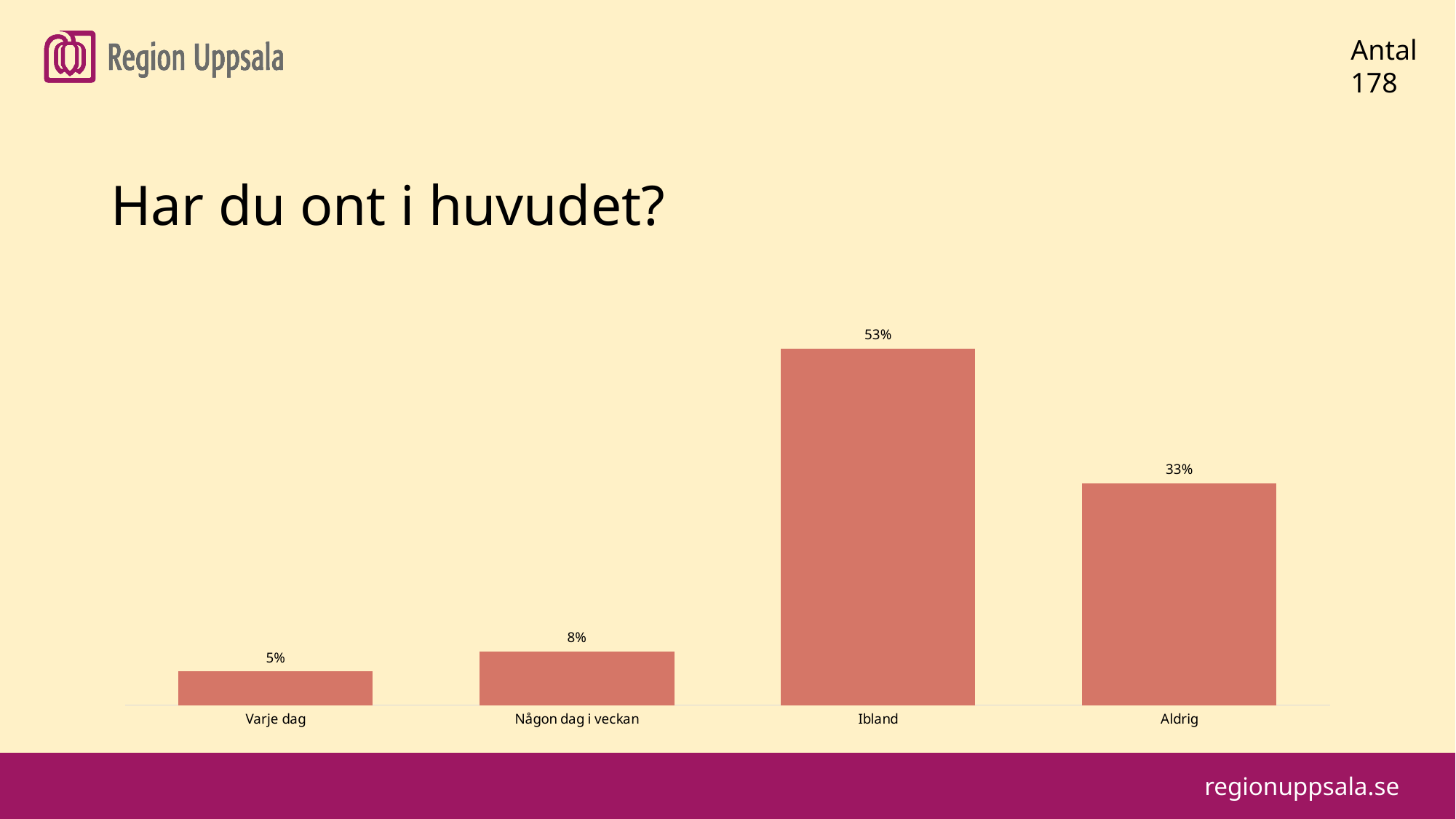
What is the value for Varje dag? 5% Which category has the highest value? Ibland What is the value for Aldrig? 33% What kind of chart is shown on the slide? Bar chart What is the title of the slide above the chart? Har du ont i huvudet? What is the value for Ibland? 53% What is the difference between the values for Ibland and Aldrig? 20% What is the value for Någon dag i veckan? 8% Which is larger, the value for Aldrig or the value for Någon dag i veckan? Aldrig How many categories are shown in the chart? 4 What is the difference between the values for Någon dag i veckan and Varje dag? 3% Which category has the lowest value? Varje dag